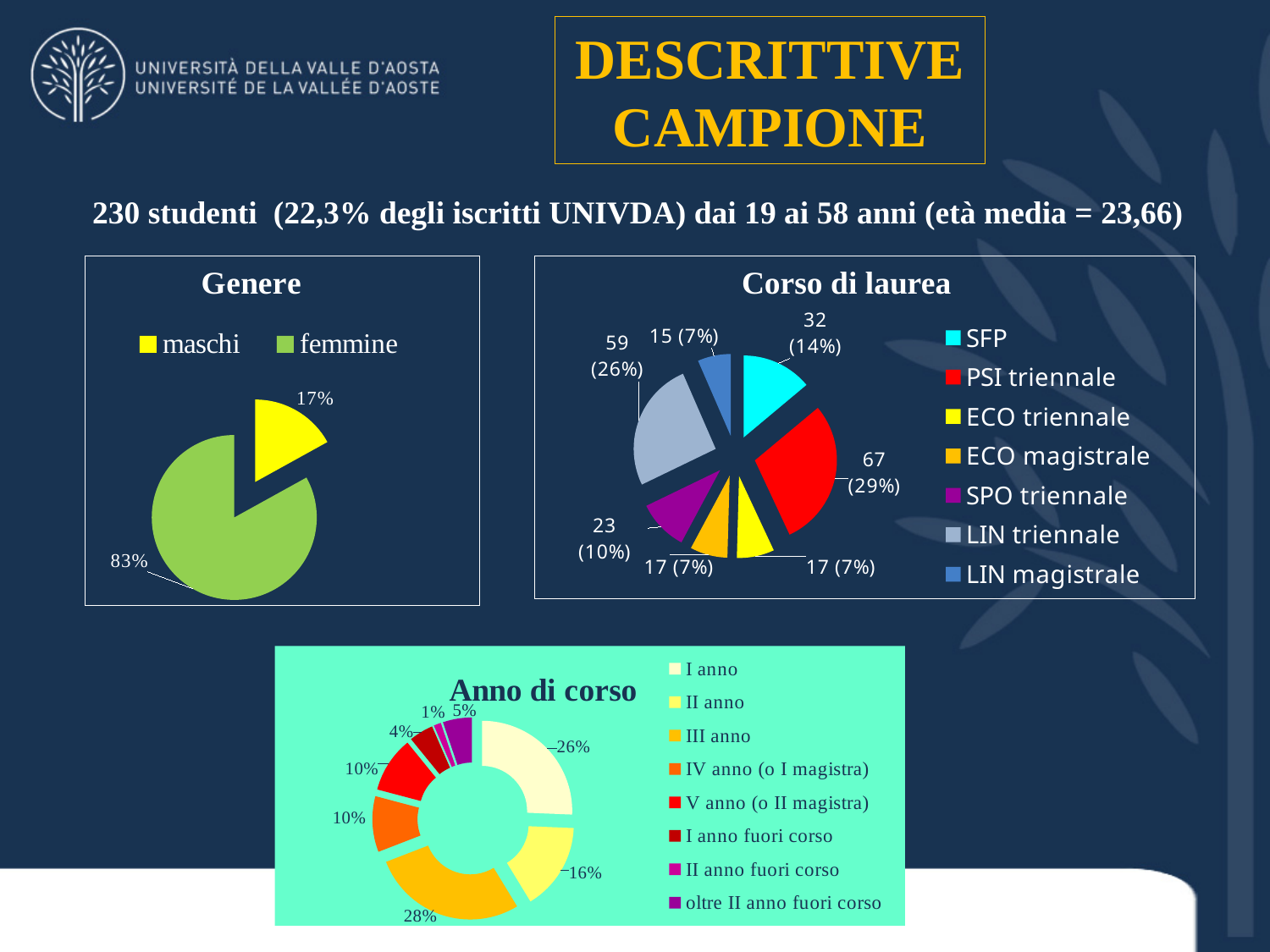
In the Corso di laurea chart, which course has the largest number of students? PSI triennale In the Corso di laurea chart, how many courses does the legend list? 7 What kind of chart is the Genere chart? pie chart In the Anno di corso chart, what percentage is shown for III anno? 28% In the Anno di corso chart, what percentage is shown for II anno? 16% In the Corso di laurea chart, which has more students, SFP or SPO triennale? SFP In the Corso di laurea chart, how many students are in LIN triennale? 59 (26%) In the Genere chart, what percentage is shown for femmine? 83% In the Genere chart, what is the difference in percentage points between femmine and maschi? 66 In the Corso di laurea chart, which course has the smallest number of students? LIN magistrale In the Corso di laurea chart, how many students are in PSI triennale? 67 (29%) In the Genere chart, what percentage is shown for maschi? 17%